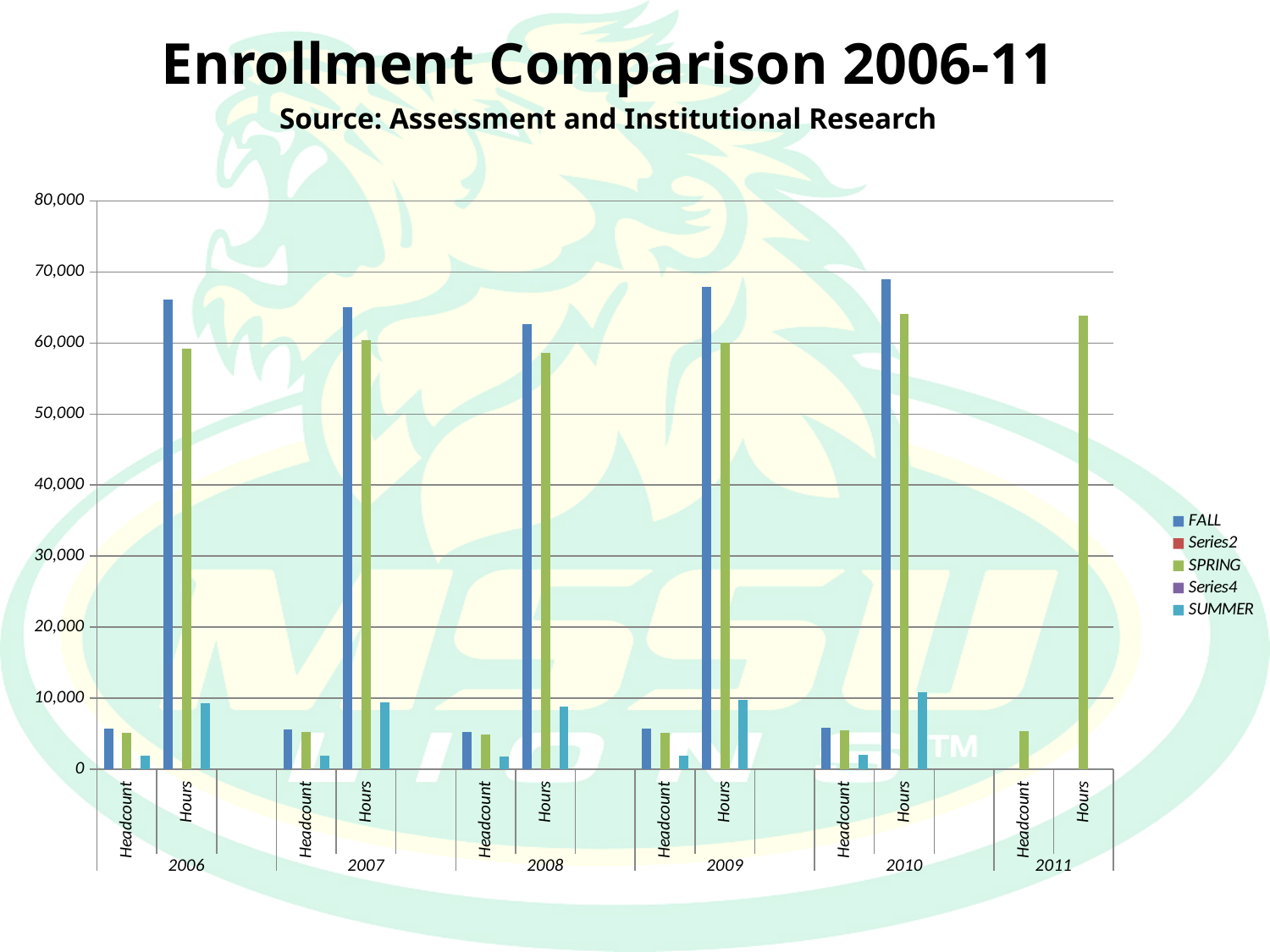
Is the SUMMER value for 2006 Hours greater or less than 10,000? less For 2006 Hours, which is larger, the FALL value or the SPRING value? FALL Which is larger, the SPRING Hours value for 2010 or for 2006? 2010 Is the FALL value for 2010 Hours greater or less than 60,000? greater How many years are shown along the x axis? 6 Is the SPRING value for 2011 Hours greater or less than 60,000? greater What kind of chart is shown on the slide? bar chart What is the title of the chart? Enrollment Comparison 2006-11 In which year is the FALL Hours value the highest? 2010 In which year is the FALL Hours value the lowest? 2008 How many series does the legend list? 5